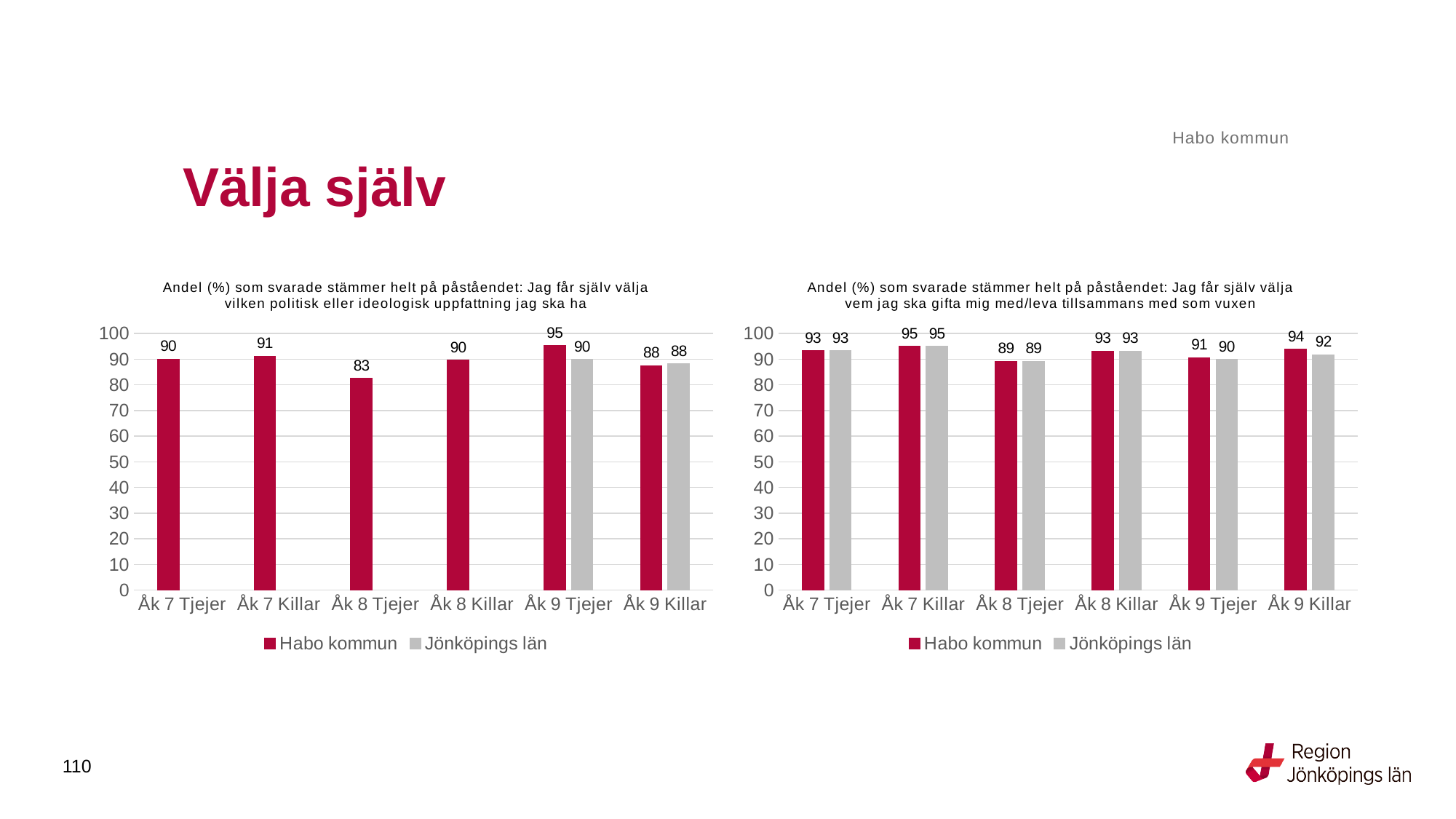
In the right chart, what is the value for Jönköpings län for Åk 9 Tjejer? 90 In the right chart, which is larger for Åk 9 Killar: Habo kommun or Jönköpings län? Habo kommun How many categories are shown on the x axis of the right chart? 6 In the left chart, what is the value for Jönköpings län for Åk 9 Killar? 88 In the right chart, what is the value for Habo kommun for Åk 9 Killar? 94 In the left chart, what is the difference between the Habo kommun values for Åk 9 Tjejer and Åk 8 Tjejer? 12 In the left chart, which category has the lowest value for Habo kommun? Åk 8 Tjejer In the right chart, which category has the lowest value for Jönköpings län? Åk 8 Tjejer In the left chart, what is the value for Habo kommun for Åk 8 Tjejer? 83 In the left chart, which category has the highest value for Habo kommun? Åk 9 Tjejer In the right chart, what is the difference between Habo kommun and Jönköpings län for Åk 9 Killar? 2 How many series does the legend of the left chart list? 2